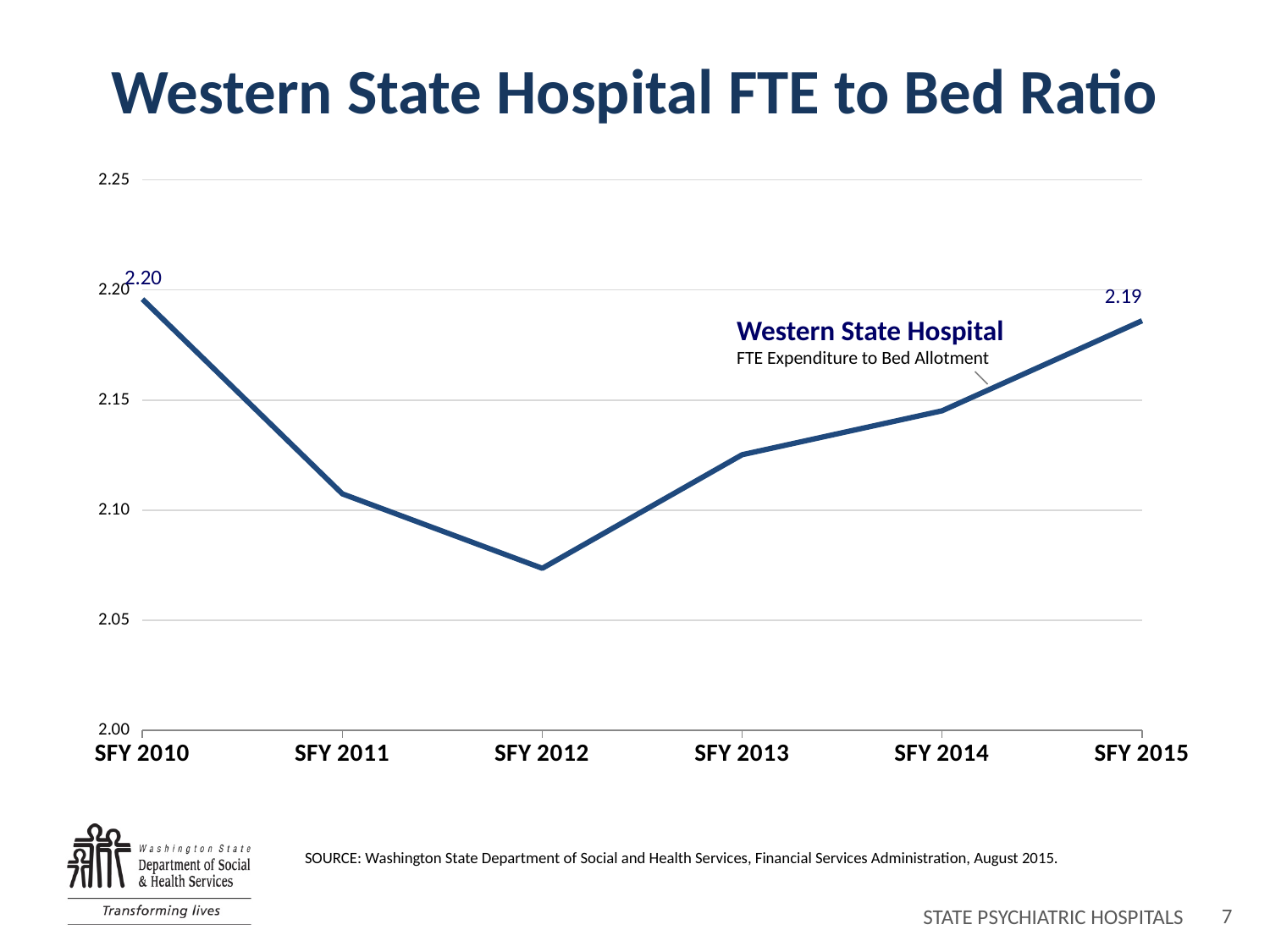
What is the title of the chart? Western State Hospital FTE to Bed Ratio How many fiscal years are plotted on the chart? 6 Does the ratio rise or fall from SFY 2012 to SFY 2015? rise What is the difference between the SFY 2010 ratio and the SFY 2015 ratio? 0.01 What is the FTE to bed ratio for SFY 2015? 2.19 What kind of chart is shown on the slide? line chart Is the value for SFY 2013 greater or less than 2.15? less Is the value for SFY 2013 greater or less than 2.10? greater Which is larger, the ratio for SFY 2010 or for SFY 2015? SFY 2010 Which fiscal year has the lowest FTE to bed ratio? SFY 2012 Is the value for SFY 2012 greater or less than 2.10? less What is the FTE to bed ratio for SFY 2010? 2.20